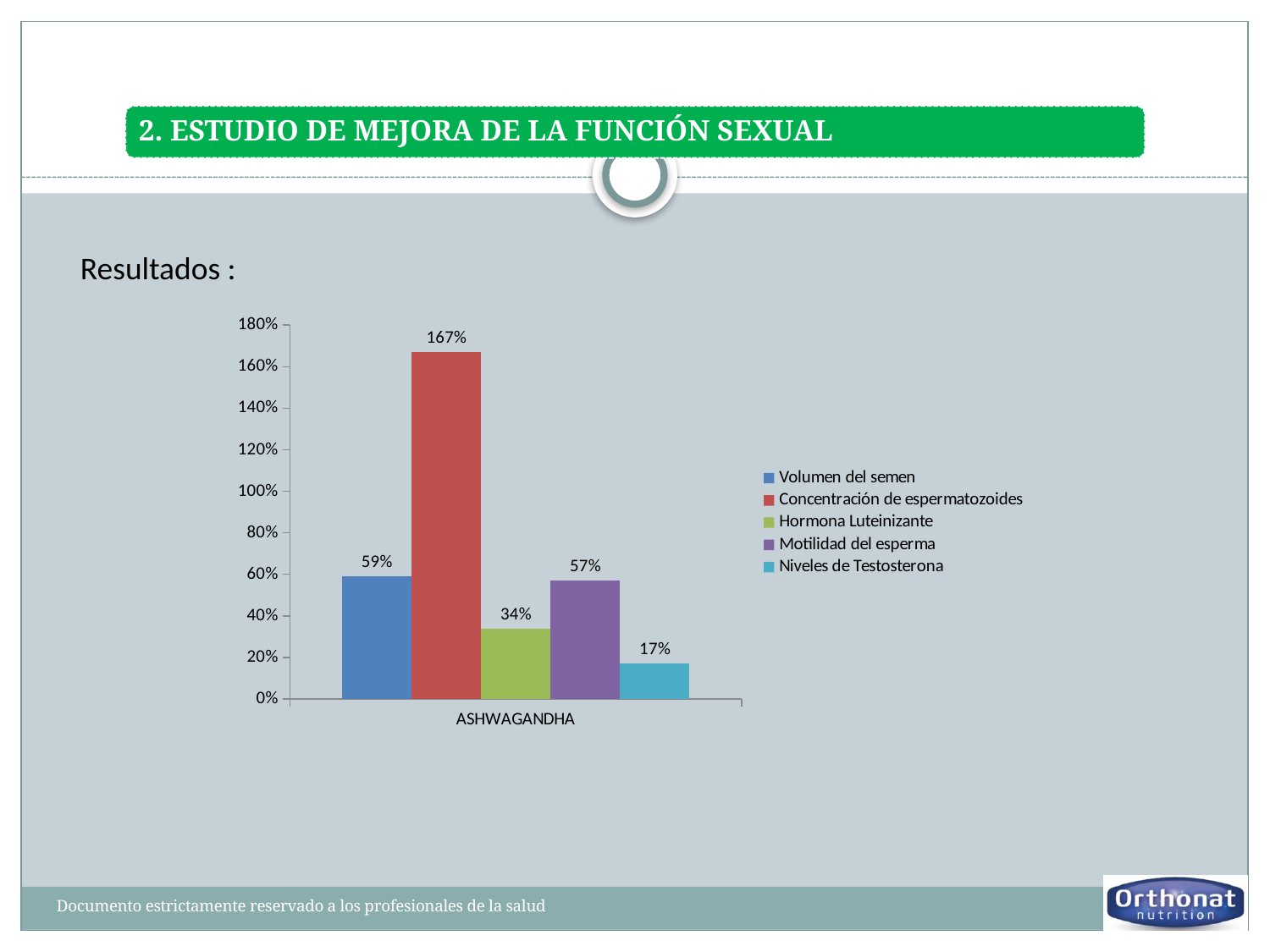
What is the category label on the x axis of the chart? ASHWAGANDHA What is the value for Hormona Luteinizante? 34% What is the difference between the values for Hormona Luteinizante and Niveles de Testosterona? 17% How many series does the legend list? 5 What is the value for Concentración de espermatozoides? 167% Which series has the lowest value? Niveles de Testosterona What kind of chart is shown on the slide? Bar chart What is the value for Niveles de Testosterona? 17% Which series has the highest value? Concentración de espermatozoides What is the difference between the values for Concentración de espermatozoides and Motilidad del esperma? 110% Which is larger, the value for Hormona Luteinizante or the value for Motilidad del esperma? Motilidad del esperma What is the value for Volumen del semen? 59%